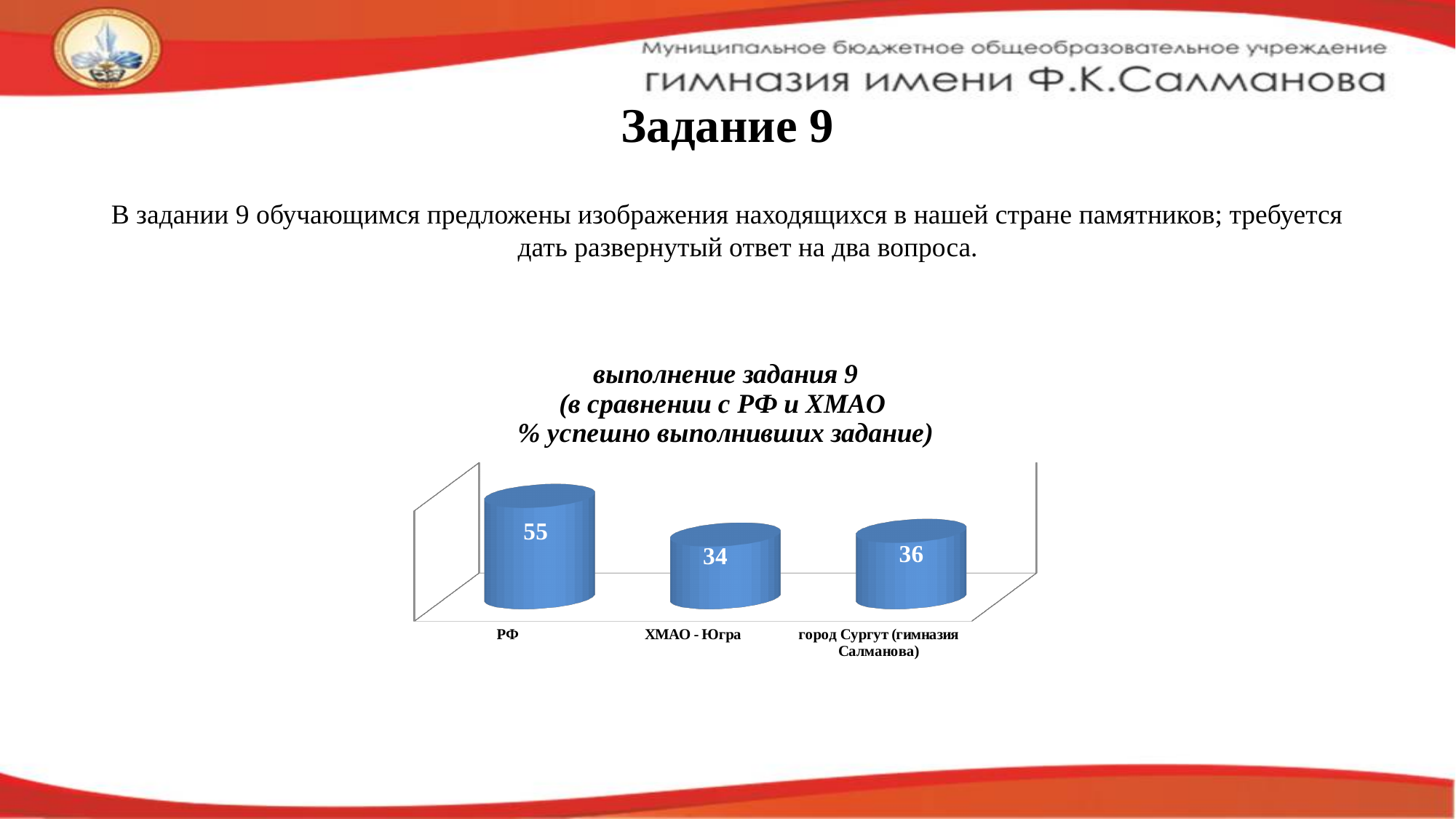
What colour are the bars in the chart? blue Which category has the highest value? РФ What is the value for РФ? 55 How many categories are shown in the chart? 3 What kind of chart is shown on the slide? bar chart What is the difference between the values for город Сургут (гимназия Салманова) and ХМАО - Югра? 2 What is the title of the chart? выполнение задания 9 (в сравнении с РФ и ХМАО % успешно выполнивших задание) What is the value for город Сургут (гимназия Салманова)? 36 What is the value for ХМАО - Югра? 34 Which category has the lowest value? ХМАО - Югра Which is larger, the value for РФ or the value for город Сургут (гимназия Салманова)? РФ What is the difference between the values for РФ and ХМАО - Югра? 21